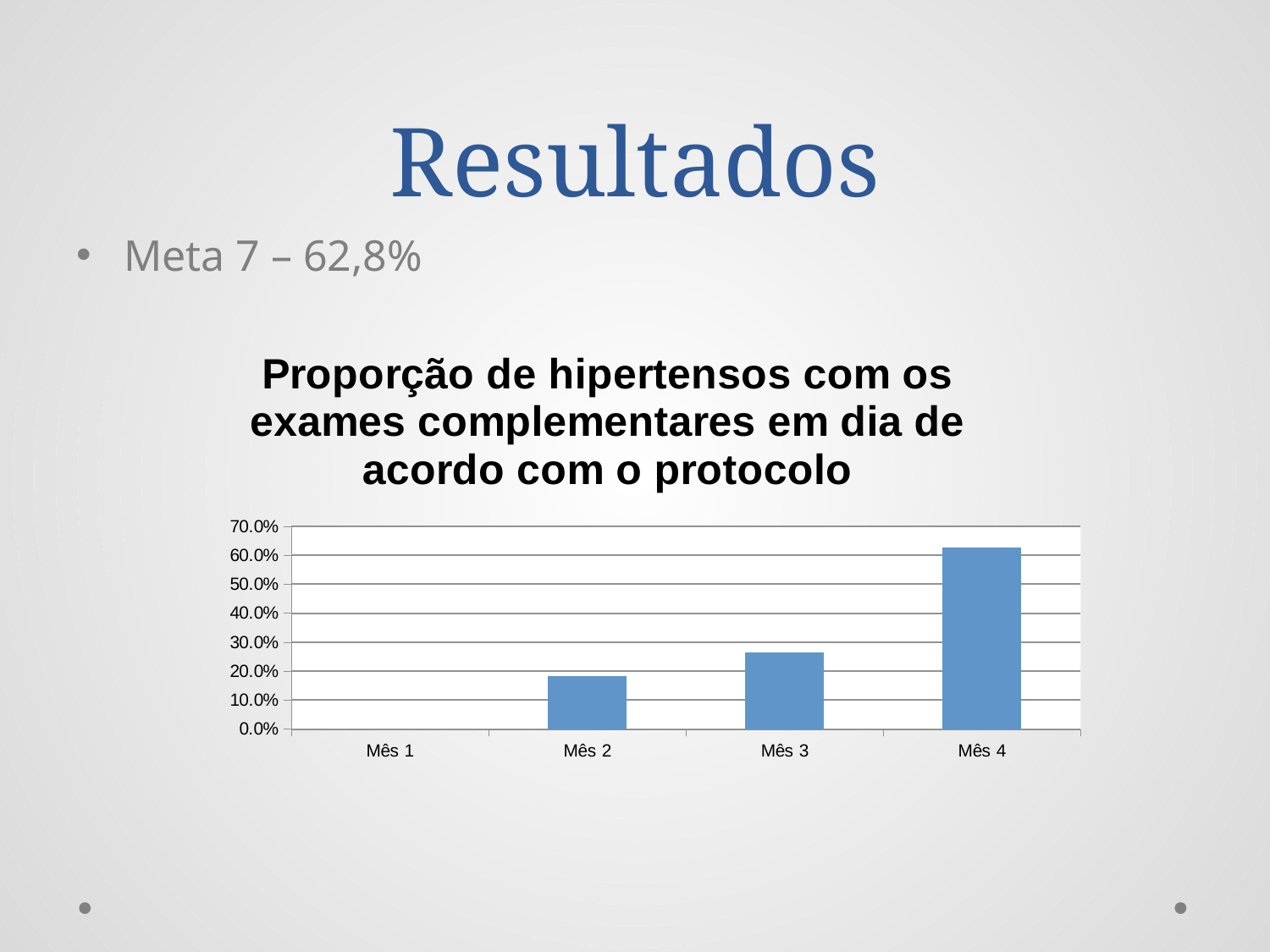
Is the value for Mês 3 greater or less than 30.0%? less What kind of chart is shown on the slide? bar chart Is the value for Mês 2 greater or less than 20.0%? less Is the value for Mês 3 greater or less than 20.0%? greater Which month has the highest proportion in the chart? Mês 4 What is the highest value shown on the y axis of the chart? 70.0% What is the title of the chart? Proporção de hipertensos com os exames complementares em dia de acordo com o protocolo How many categories (months) are shown on the x axis of the chart? 4 Which month has the lowest proportion in the chart? Mês 1 Do the values rise or fall from Mês 1 to Mês 4? rise Which is larger, the value for Mês 2 or the value for Mês 3? Mês 3